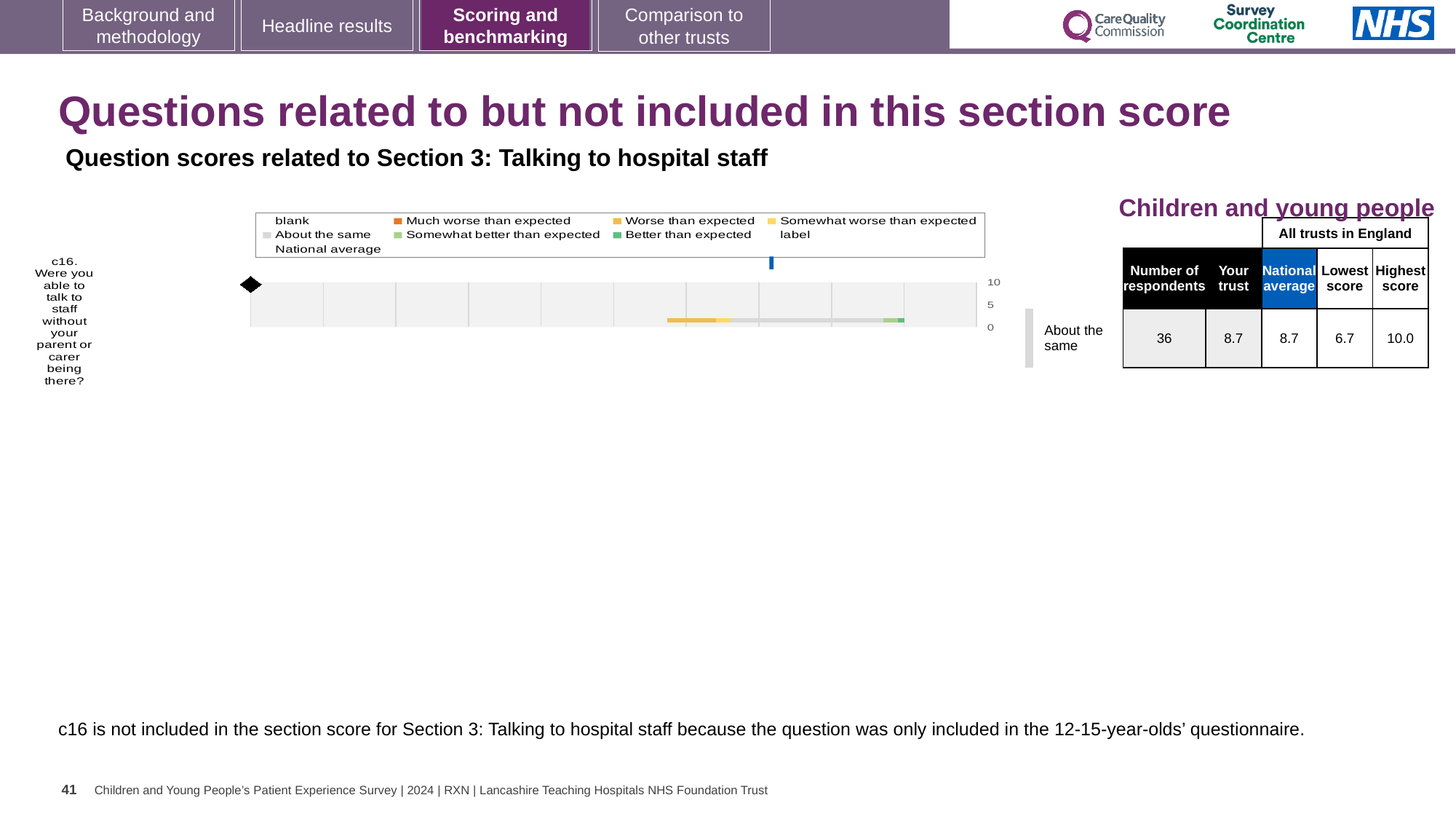
What is the national average score for c16? 8.7 What is the highest score among all trusts in England for c16? 10.0 What is the difference between the highest score and the lowest score for c16? 3.3 Which question is plotted in the chart? c16. Were you able to talk to staff without your parent or carer being there? Is the 'Your trust' score for c16 larger than, smaller than, or equal to the national average? equal How many questions (categories) are plotted in the chart? 1 How many respondents answered c16? 36 What is the 'Your trust' score for c16? 8.7 What is the lowest score among all trusts in England for c16? 6.7 What kind of chart is shown for question c16? bar chart Which legend entry is shown in orange? Much worse than expected What benchmark category label is shown next to the chart for c16? About the same